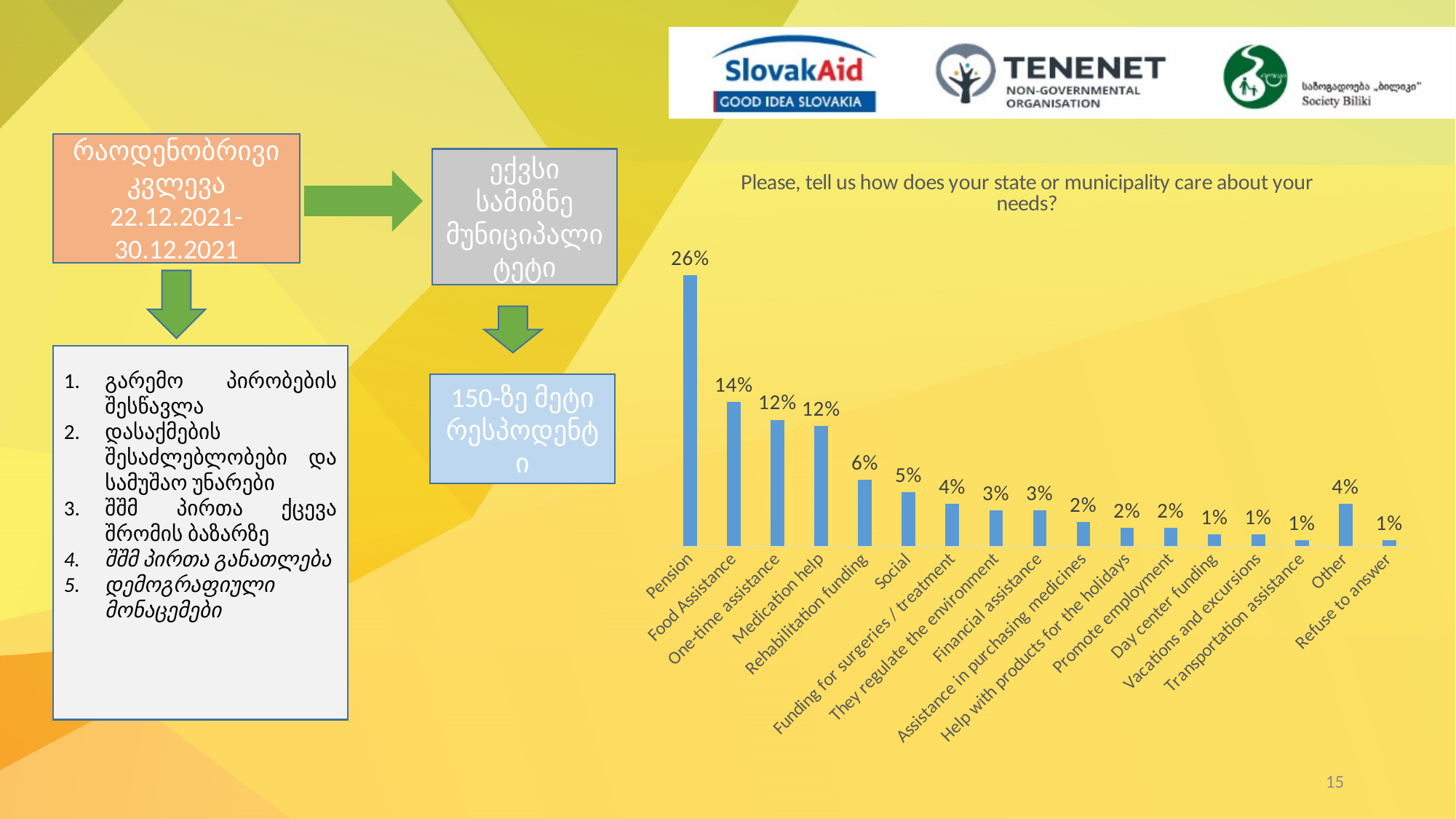
What is the value for Rehabilitation funding? 6% What is the value for Other? 4% How many categories are shown on the x axis? 17 What is the title of the chart? Please, tell us how does your state or municipality care about your needs? Which is larger, the value for Social or the value for Other? Social What is the difference between the values for Pension and Food Assistance? 12% What is the difference between the values for Medication help and Rehabilitation funding? 6% What is the value for Promote employment? 2% Which category has the highest value? Pension What is the value for Food Assistance? 14% What is the value for Pension? 26% What type of chart is shown on the slide? bar chart